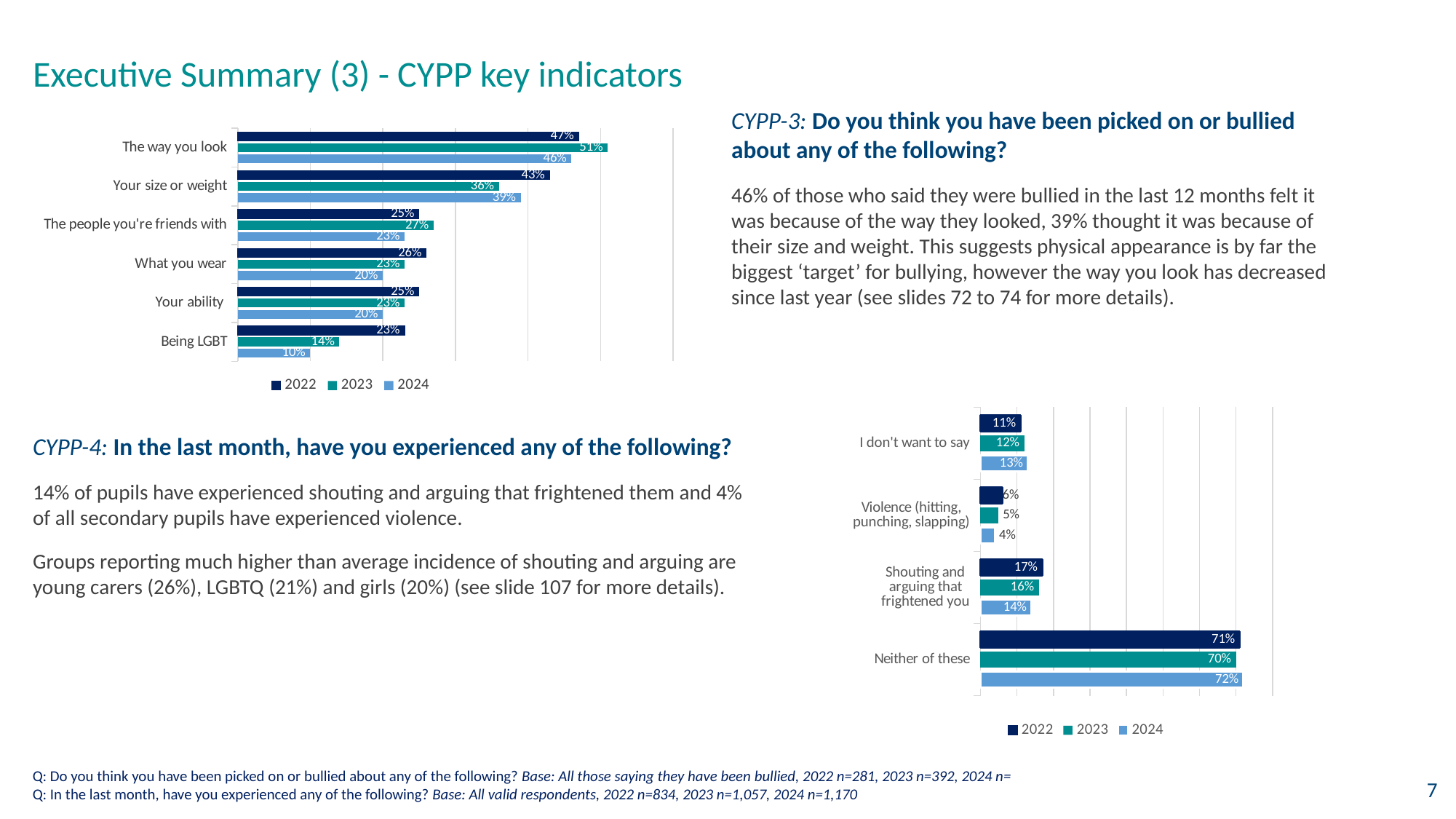
In the top-left chart, what is the 2024 value for 'The way you look'? 46% In the bottom-right chart, which category has the highest 2022 value? Neither of these In the bottom-right chart, what is the difference between the 2022 and 2024 values for 'Violence (hitting, punching, slapping)'? 2% In the top-left chart, how many categories are shown? 6 In the bottom-right chart, what is the 2024 value for 'Shouting and arguing that frightened you'? 14% What kind of chart is the bottom-right chart? bar chart In the top-left chart, which is larger for 'The people you're friends with': the 2022 value or the 2023 value? 2023 In the top-left chart, what is the difference between the 2022 and 2024 values for 'Being LGBT'? 13% In the top-left chart, how many series does the legend list? 3 In the top-left chart, which category has the lowest 2024 value? Being LGBT In the bottom-right chart, do the values for 'I don't want to say' rise or fall from 2022 to 2024? rise In the top-left chart, what is the 2023 value for 'Your size or weight'? 36%